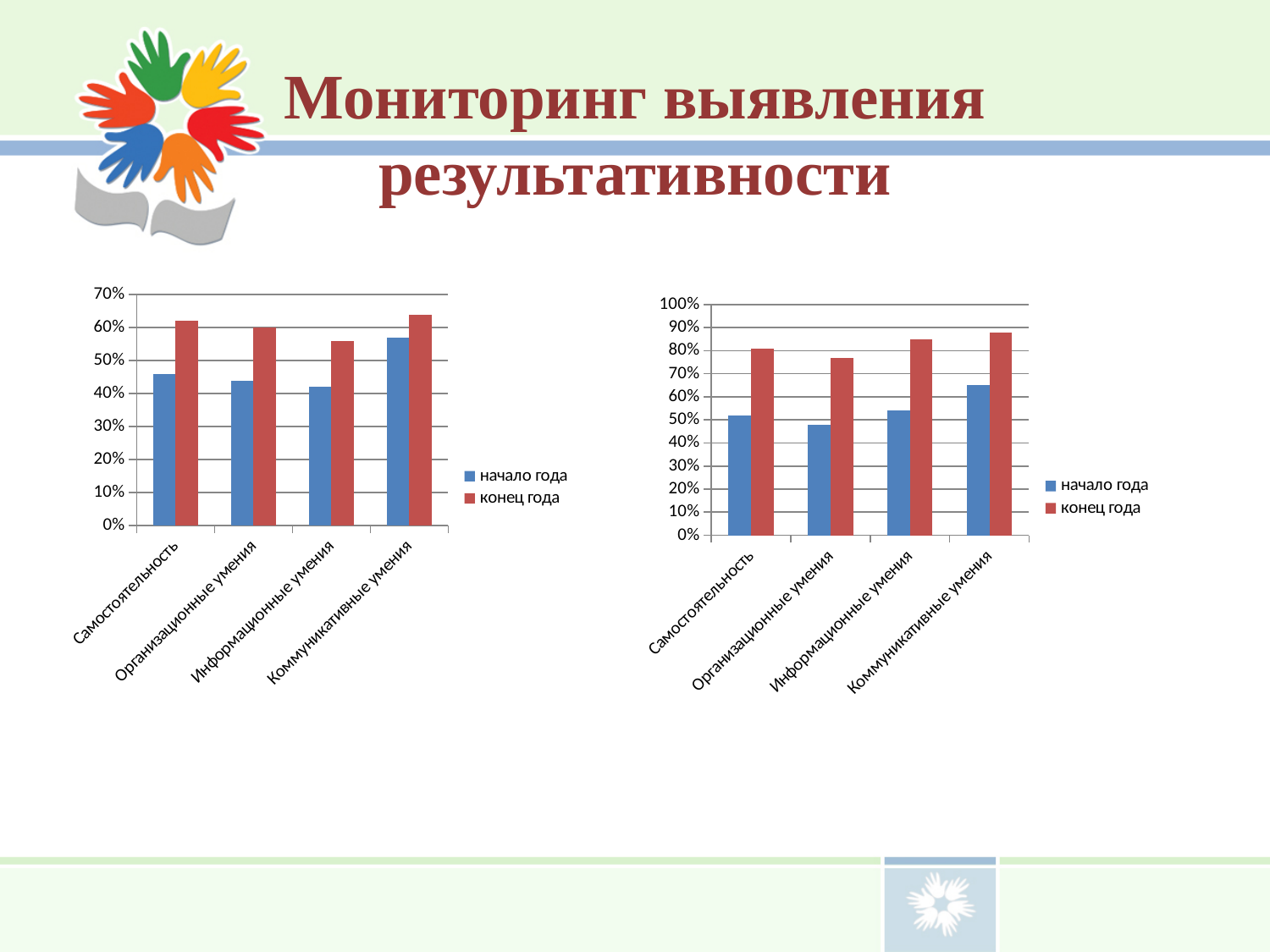
In the left chart, for Самостоятельность, which is larger: начало года or конец года? конец года What kind of chart is the left chart on the slide? bar chart What is the top value shown on the y axis of the right chart? 100% In the right chart, is the value for Коммуникативные умения at начало года greater or less than 60%? greater In the right chart, is the value for Информационные умения at конец года greater or less than 80%? greater In the left chart, which category has the lowest value for конец года? Информационные умения How many categories are shown on the x axis of the right chart? 4 In the left chart, is the value for Информационные умения at начало года greater or less than 50%? less In the right chart, which category has the lowest value for конец года? Организационные умения In the right chart, which category has the highest value for начало года? Коммуникативные умения In the left chart, which category has the highest value for начало года? Коммуникативные умения How many series does the legend of the left chart list? 2